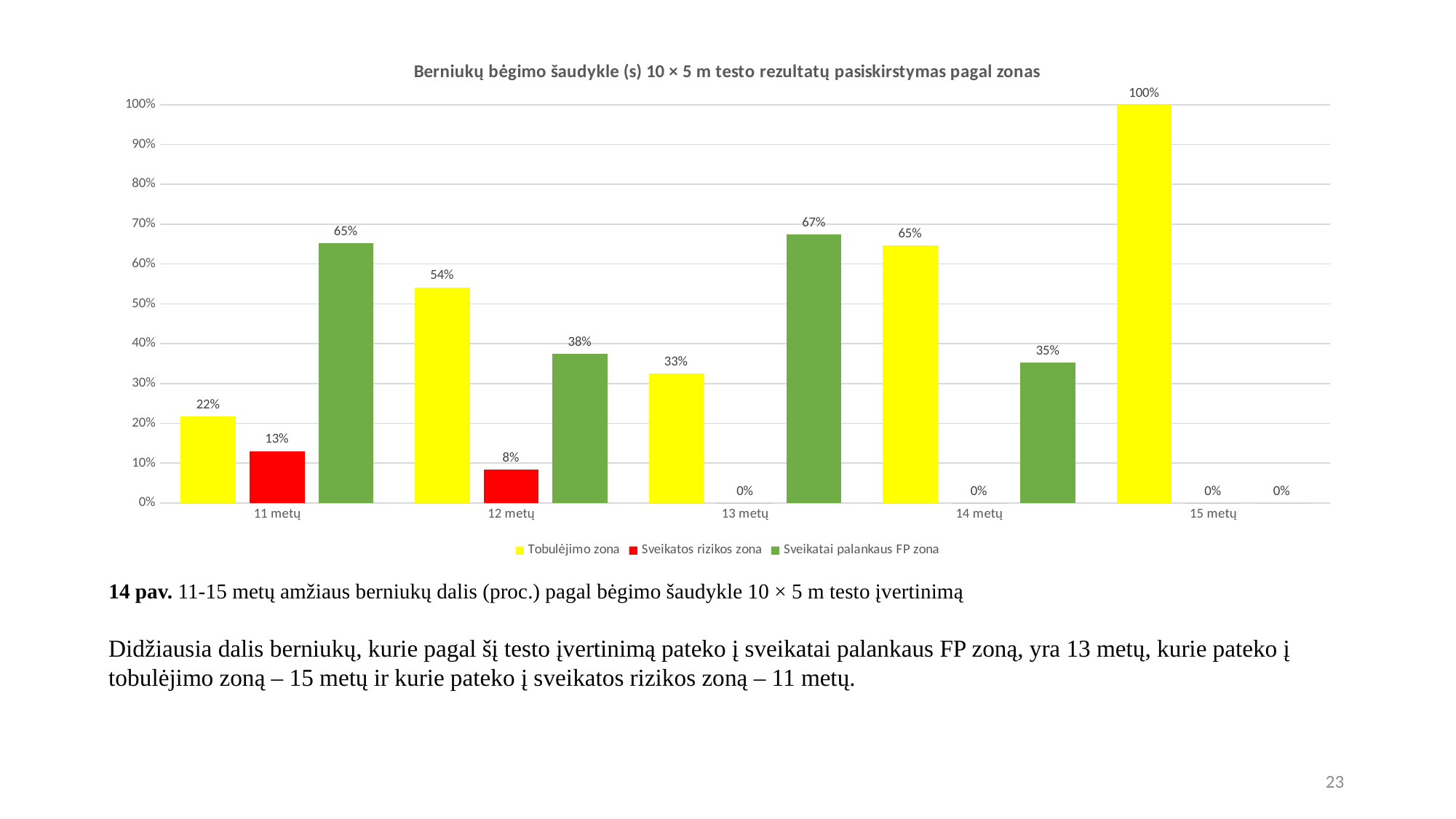
Which age group has the highest value for Tobulėjimo zona? 15 metų What colour represents Sveikatos rizikos zona in the chart? red What is the difference between Sveikatai palankaus FP zona and Tobulėjimo zona for 11 metų? 43% What is the value of Sveikatai palankaus FP zona for 13 metų? 67% What is the value of Tobulėjimo zona for 12 metų? 54% What type of chart is shown on the slide? bar chart Which age group has the lowest value for Sveikatai palankaus FP zona? 15 metų How many age categories are shown on the x axis? 5 For 14 metų, which is larger: Tobulėjimo zona or Sveikatai palankaus FP zona? Tobulėjimo zona What is the value of Sveikatos rizikos zona for 11 metų? 13% How many series does the legend list? 3 Does the value of Sveikatos rizikos zona rise or fall from 11 metų to 12 metų? fall